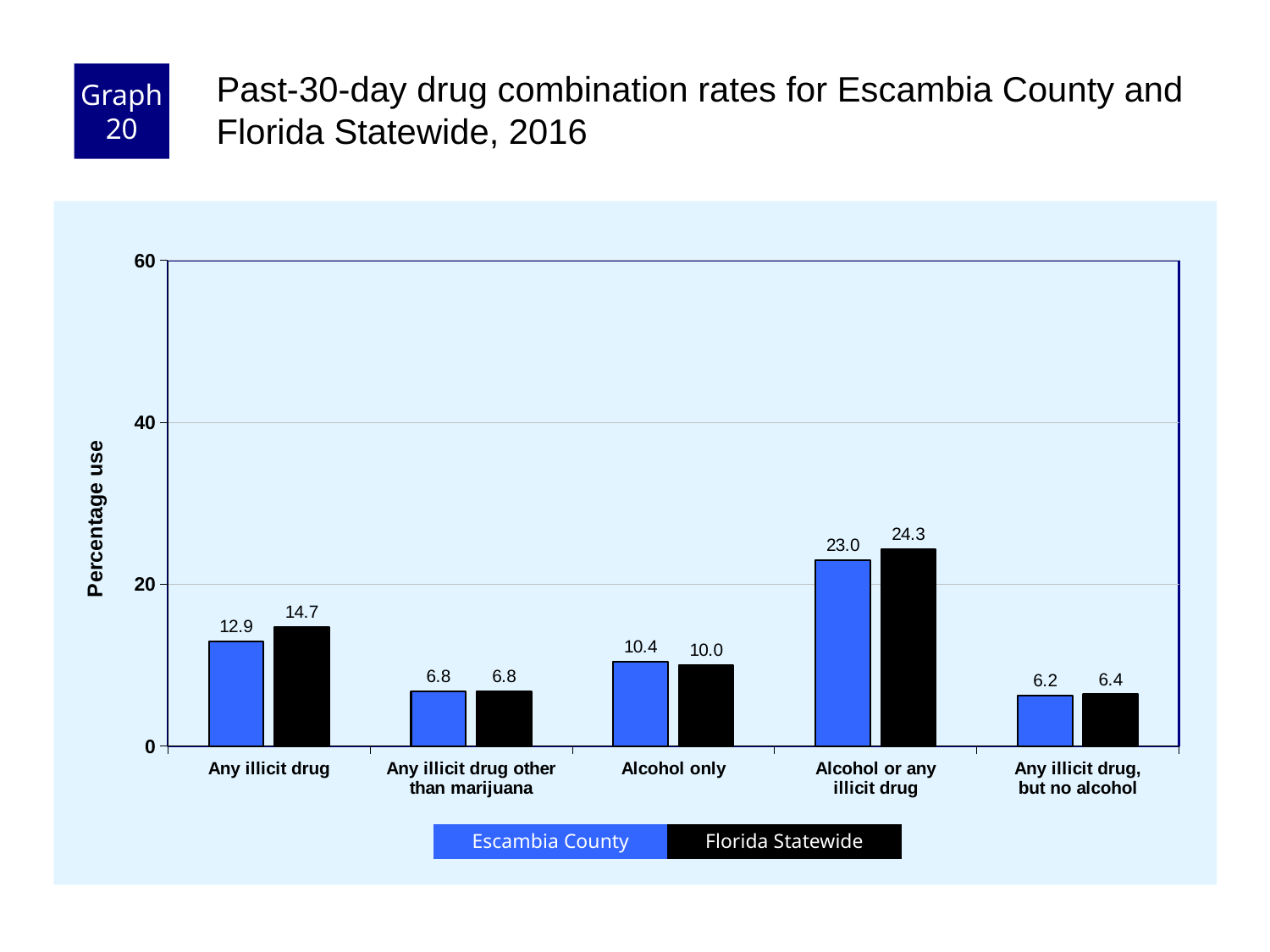
What is the Escambia County value for Any illicit drug? 12.9 How many series does the legend list? 2 Is the Florida Statewide value for Alcohol or any illicit drug greater or less than 20? greater How many categories are shown on the x axis? 5 Which category has the highest Escambia County value? Alcohol or any illicit drug For Alcohol only, which is larger: Escambia County or Florida Statewide? Escambia County What kind of chart is shown on the slide? Bar chart What is the difference between the Florida Statewide and Escambia County values for Any illicit drug? 1.8 What is the Florida Statewide value for Alcohol or any illicit drug? 24.3 Which category has the lowest Florida Statewide value? Any illicit drug, but no alcohol What is the Florida Statewide value for Any illicit drug, but no alcohol? 6.4 What is the label of the y axis? Percentage use